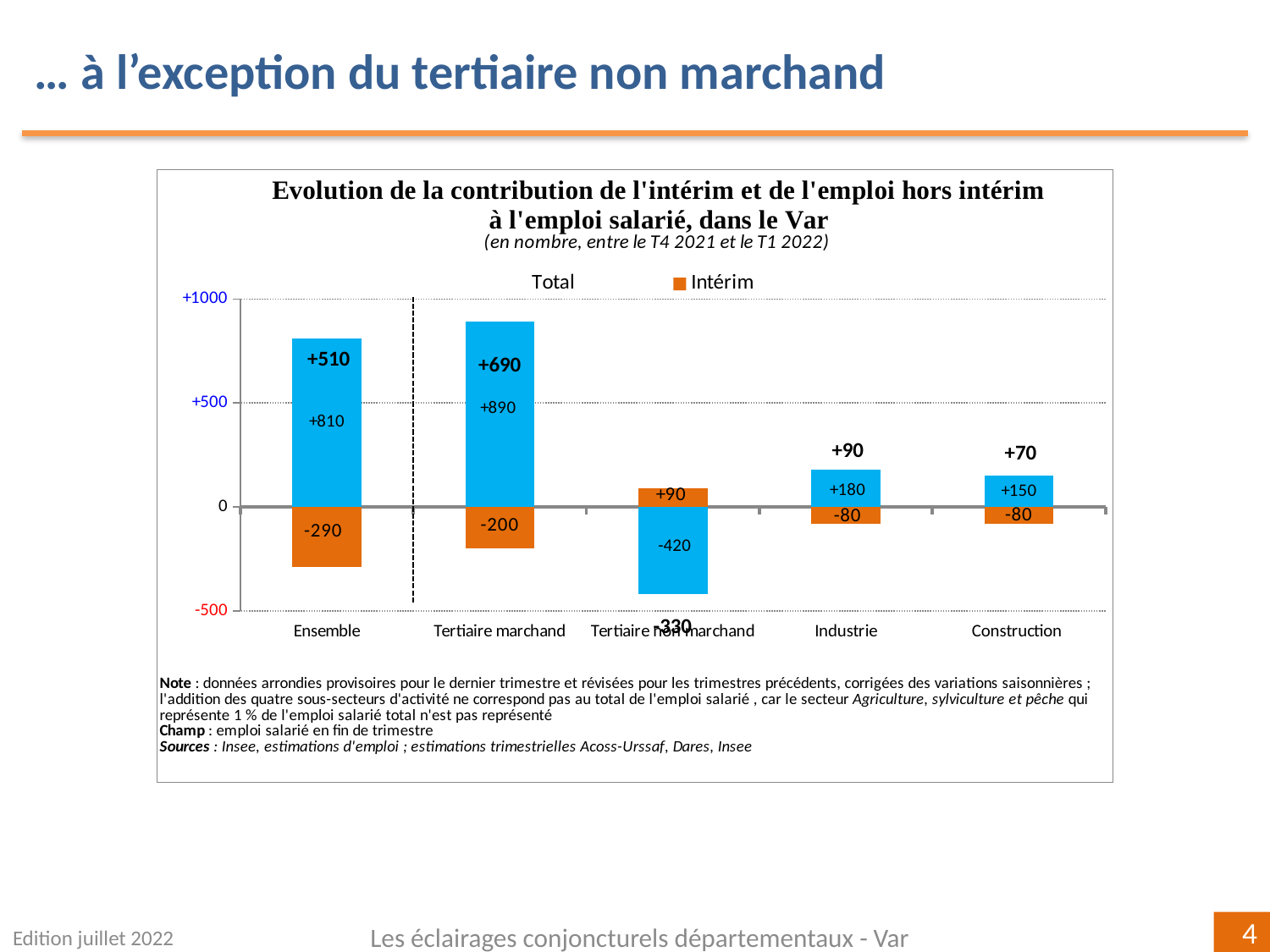
Which category has the lowest total? Tertiaire non marchand What is the value of the blue segment for Tertiaire marchand? +890 What is the difference between the blue segment values for Industrie (+180) and Construction (+150)? 30 What is the value of the Intérim segment for Construction? -80 What kind of chart is this? bar chart Which category has the highest total? Tertiaire marchand What is the value of the blue segment for Tertiaire non marchand? -420 Is the total for Ensemble larger or smaller than the total for Tertiaire marchand? smaller What is the total shown for Tertiaire marchand? +690 How many categories are shown on the x axis? 5 What is the total shown for Industrie? +90 What is the value of the Intérim (orange) segment for Ensemble? -290